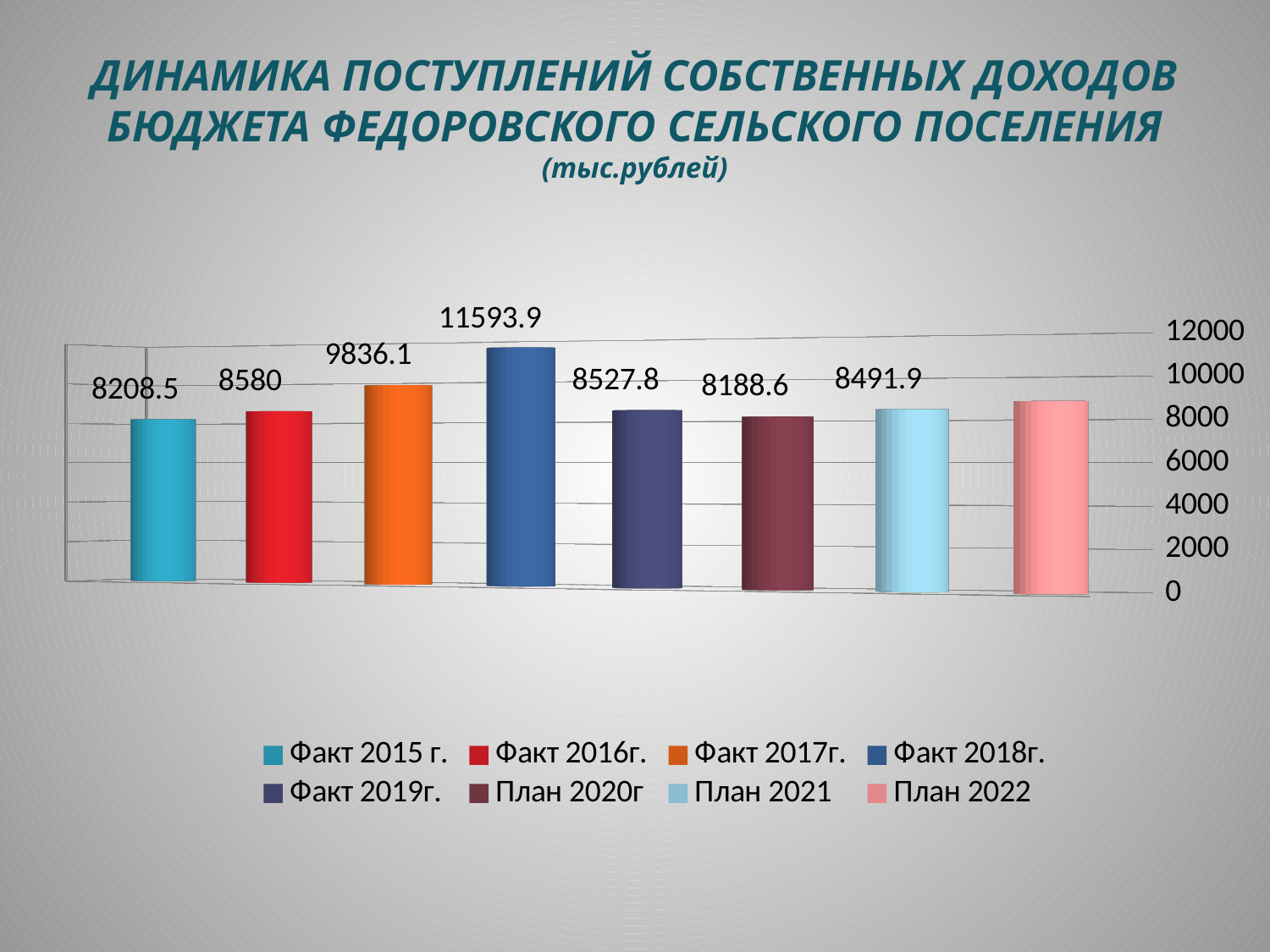
How many entries does the legend list? 8 What is the value for Факт 2015 г.? 8208.5 What kind of chart is shown on the slide? bar chart Which legend entry has the highest value? Факт 2018г. What is the value for Факт 2018г.? 11593.9 Which is larger, the value for Факт 2017г. or the value for Факт 2019г.? Факт 2017г. Is the value for План 2022 greater or less than 10000? less How many bars are plotted on the chart? 8 What is the difference between the values for Факт 2018г. and Факт 2017г.? 1757.8 Which legend entry has the lowest value? План 2020г What is the value for План 2021? 8491.9 What is the difference between the values for Факт 2016г. and Факт 2015 г.? 371.5